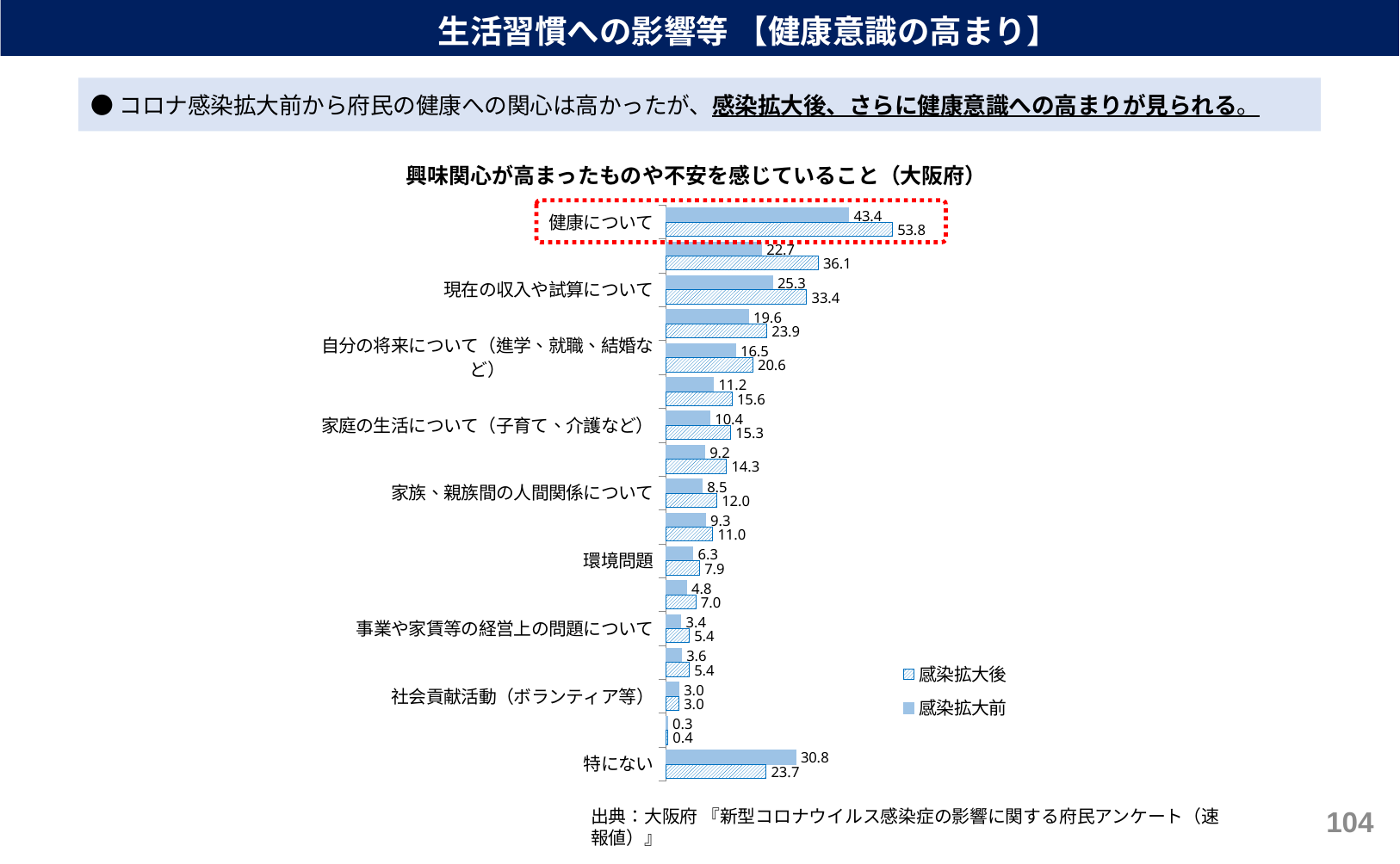
What is the value for 健康について in the 感染拡大前 series? 43.4 What is the difference between the 感染拡大後 and 感染拡大前 values for 健康について? 10.4 What is the difference between the 感染拡大後 and 感染拡大前 values for 現在の収入や試算について? 8.1 What is the value for 社会貢献活動（ボランティア等） in the 感染拡大後 series? 3.0 Which category has the highest 感染拡大後 value? 健康について What is the value for 現在の収入や試算について in the 感染拡大後 series? 33.4 What is the value for 健康について in the 感染拡大後 series? 53.8 What is the value for 環境問題 in the 感染拡大前 series? 6.3 How many series does the legend list? 2 For 特にない, which series has the larger value, 感染拡大後 or 感染拡大前? 感染拡大前 What kind of chart is shown on the slide? Bar chart What is the title of the chart? 興味関心が高まったものや不安を感じていること（大阪府）